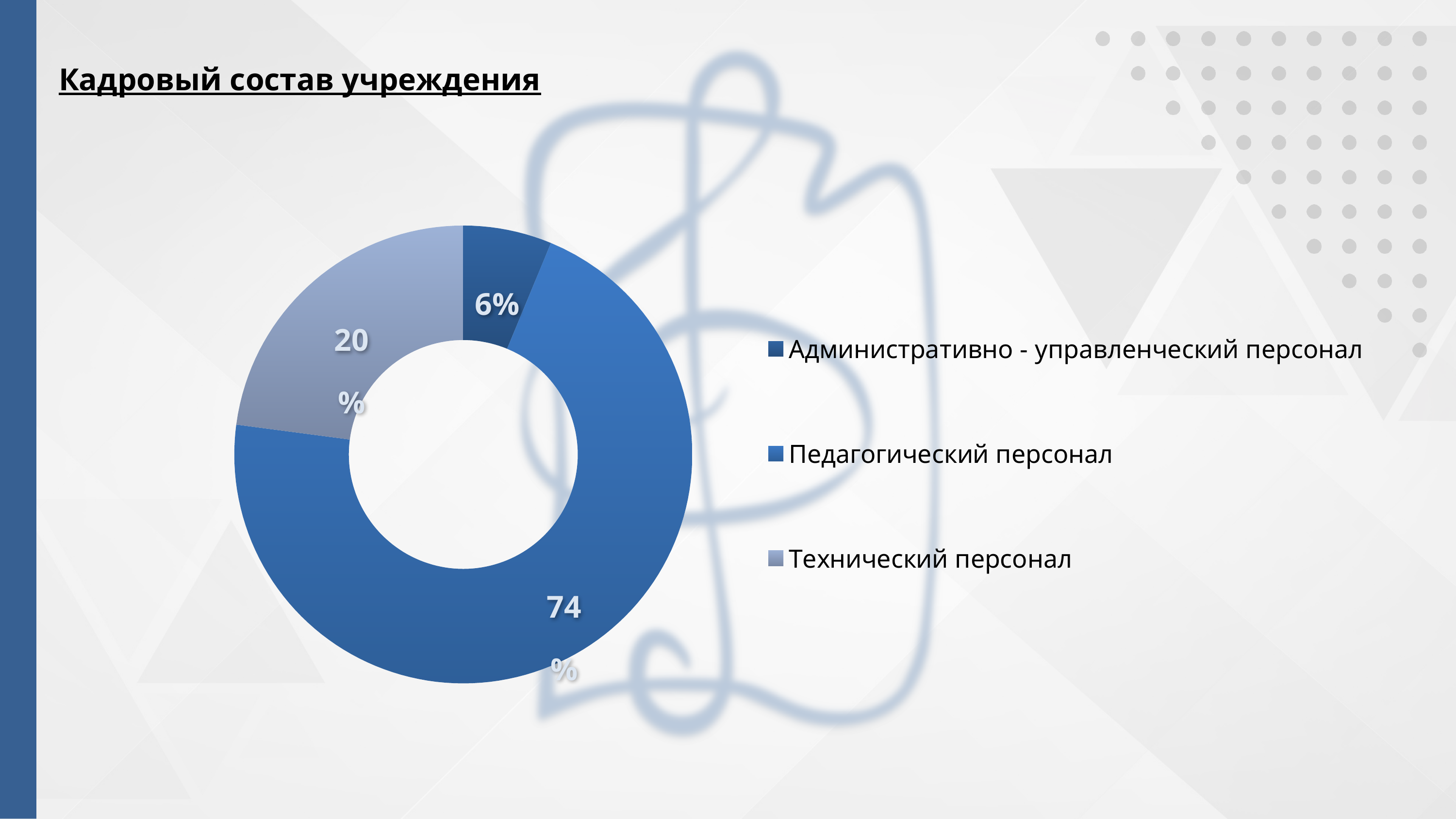
What share of the staff is Педагогический персонал? 74% How many categories does the chart show? 3 Which category has the smallest share of the staff? Административно - управленческий персонал What share of the staff is Административно - управленческий персонал? 6% What is the difference in percentage points between Педагогический персонал and Технический персонал? 54 What is the difference in percentage points between Технический персонал and Административно - управленческий персонал? 14 What share of the staff is Технический персонал? 20% What kind of chart is shown on the slide? Doughnut (pie) chart Which is larger: the share of Технический персонал or Административно - управленческий персонал? Технический персонал What is the title of the slide? Кадровый состав учреждения Which category has the largest share of the staff? Педагогический персонал Which category is shown in the lightest (grey-blue) colour? Технический персонал